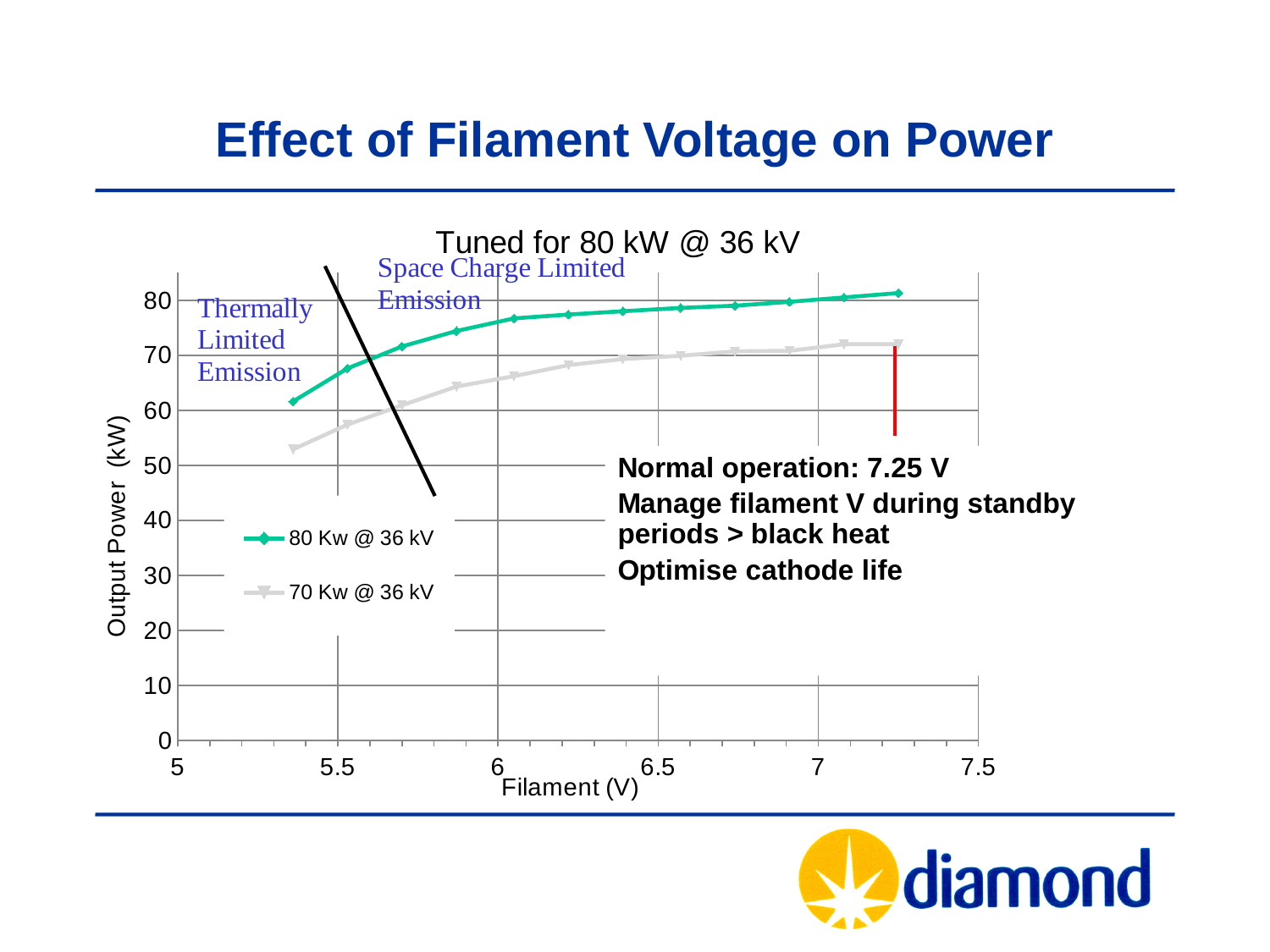
Is the output power for the 80 Kw @ 36 kV series at 5.5 V greater or less than 70? less Is the lowest output power plotted for the 70 Kw @ 36 kV series greater or less than 50? greater What is the label of the chart's y axis? Output Power (kW) What is the title of the chart? Tuned for 80 kW @ 36 kV Is the output power for the 70 Kw @ 36 kV series at 6 V greater or less than 70? less Does the output power for the 70 Kw @ 36 kV series rise or fall as filament voltage increases? rise Which series has the higher output power at a filament voltage of 6.5 V, 80 Kw @ 36 kV or 70 Kw @ 36 kV? 80 Kw @ 36 kV Does the output power for the 80 Kw @ 36 kV series rise or fall as filament voltage increases? rise What kind of chart is shown on the slide? line chart How many series does the chart legend list? 2